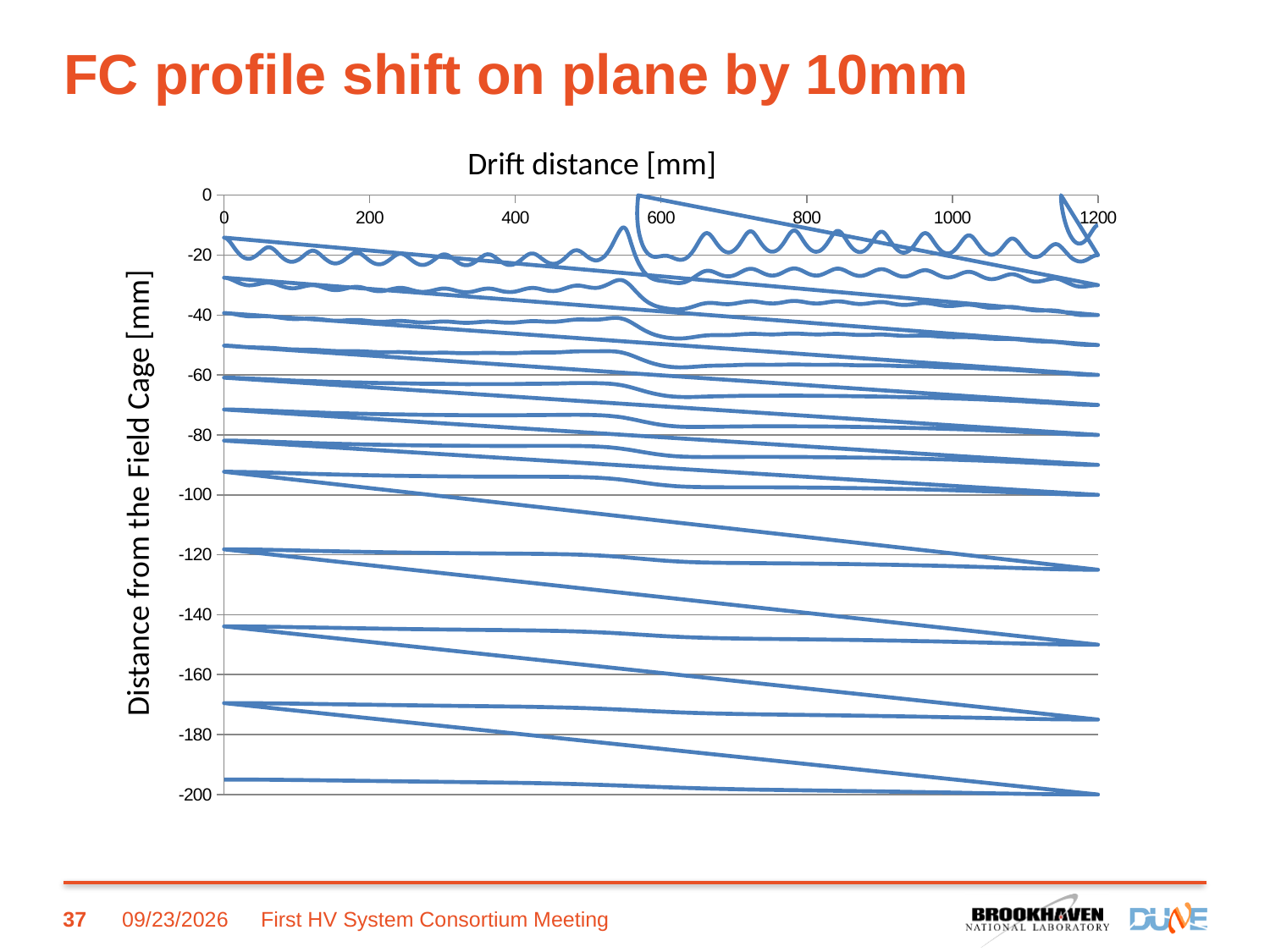
What is the label of the horizontal axis of the chart? Drift distance [mm] Along the x axis, do the plotted lines generally rise or fall as drift distance increases? fall What is the label of the vertical axis of the chart? Distance from the Field Cage [mm] Is the value of the lowest plotted line at drift distance 0 greater or less than -180? less Is the value of the lowest plotted line at drift distance 1200 greater or less than -180? less What kind of chart is shown on the slide? line chart